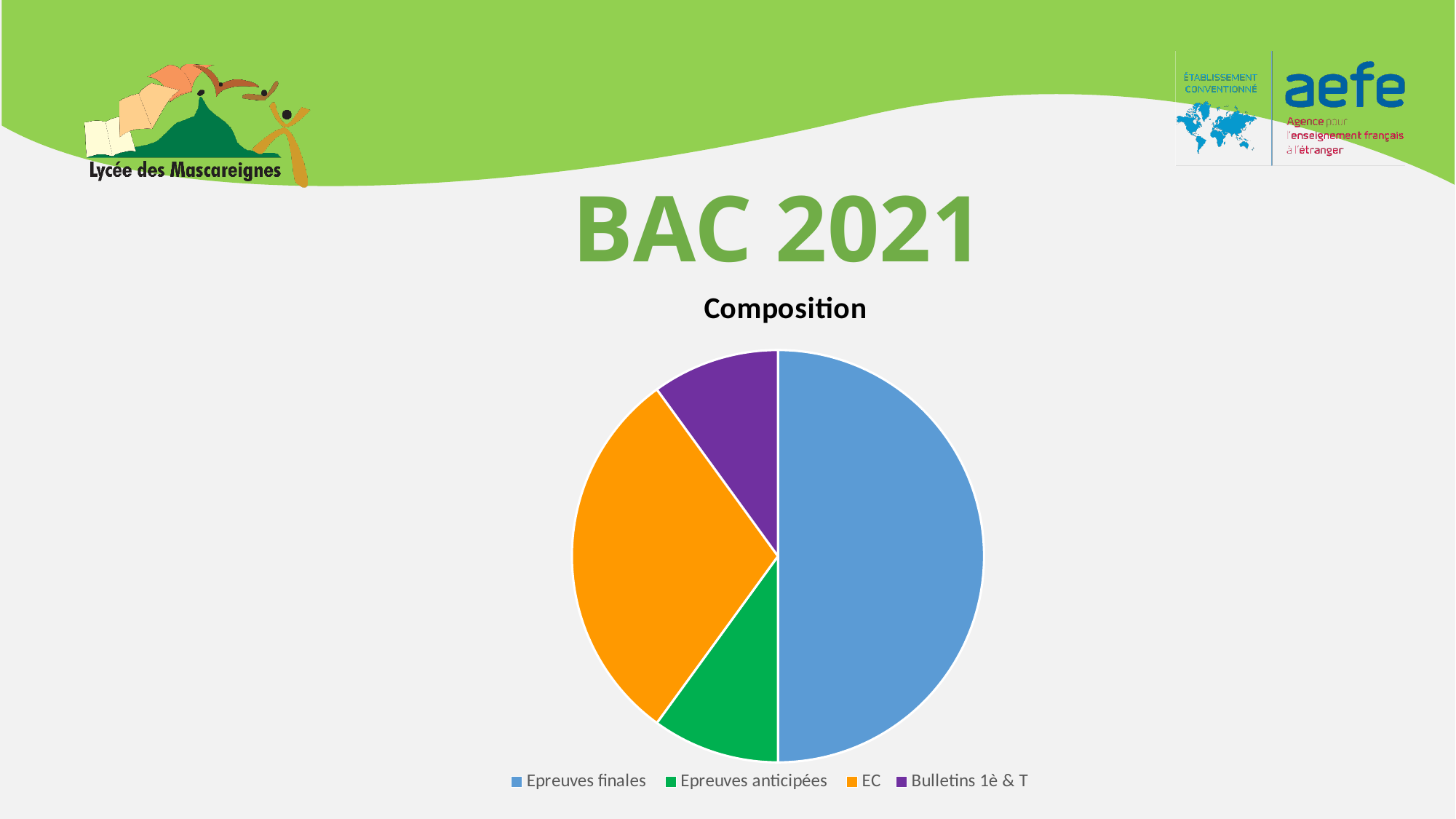
Which is larger, the slice for Epreuves finales or the slice for EC? Epreuves finales Which category has the largest slice of the pie? Epreuves finales How many entries does the legend list? 4 Which is larger, the slice for EC or the slice for Bulletins 1è & T? EC Which colour represents EC in the pie chart? orange How many slices does the pie chart have? 4 Which is larger, the slice for EC or the slice for Epreuves anticipées? EC What is the title of the chart? Composition What kind of chart is shown on the slide? pie chart